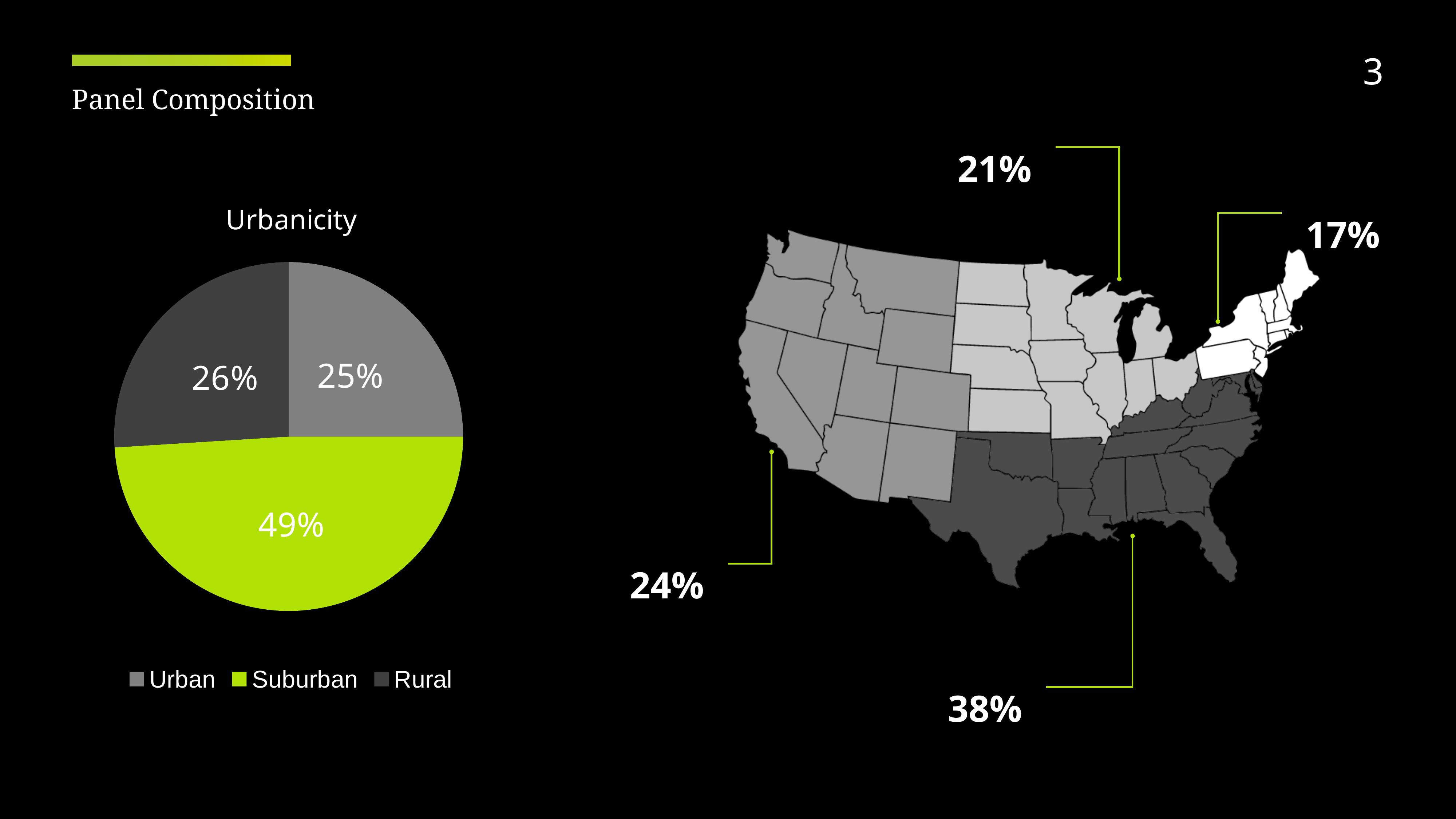
In the Urbanicity pie chart, what percentage is Rural? 26% What type of chart is the Urbanicity chart? Pie chart What is the largest percentage shown on the US map? 38% In the Urbanicity pie chart, which category has the largest share? Suburban In the Urbanicity pie chart, what is the difference in percentage points between Rural and Urban? 1 In the Urbanicity pie chart, what percentage is Urban? 25% How many slices does the Urbanicity pie chart have? 3 In the Urbanicity pie chart, what is the difference in percentage points between Suburban and Rural? 23 In the Urbanicity pie chart, which is larger, Suburban or Urban? Suburban In the Urbanicity pie chart, what percentage is Suburban? 49% In the Urbanicity pie chart, which category has the smallest share? Urban In the Urbanicity pie chart, which category is shown in green? Suburban